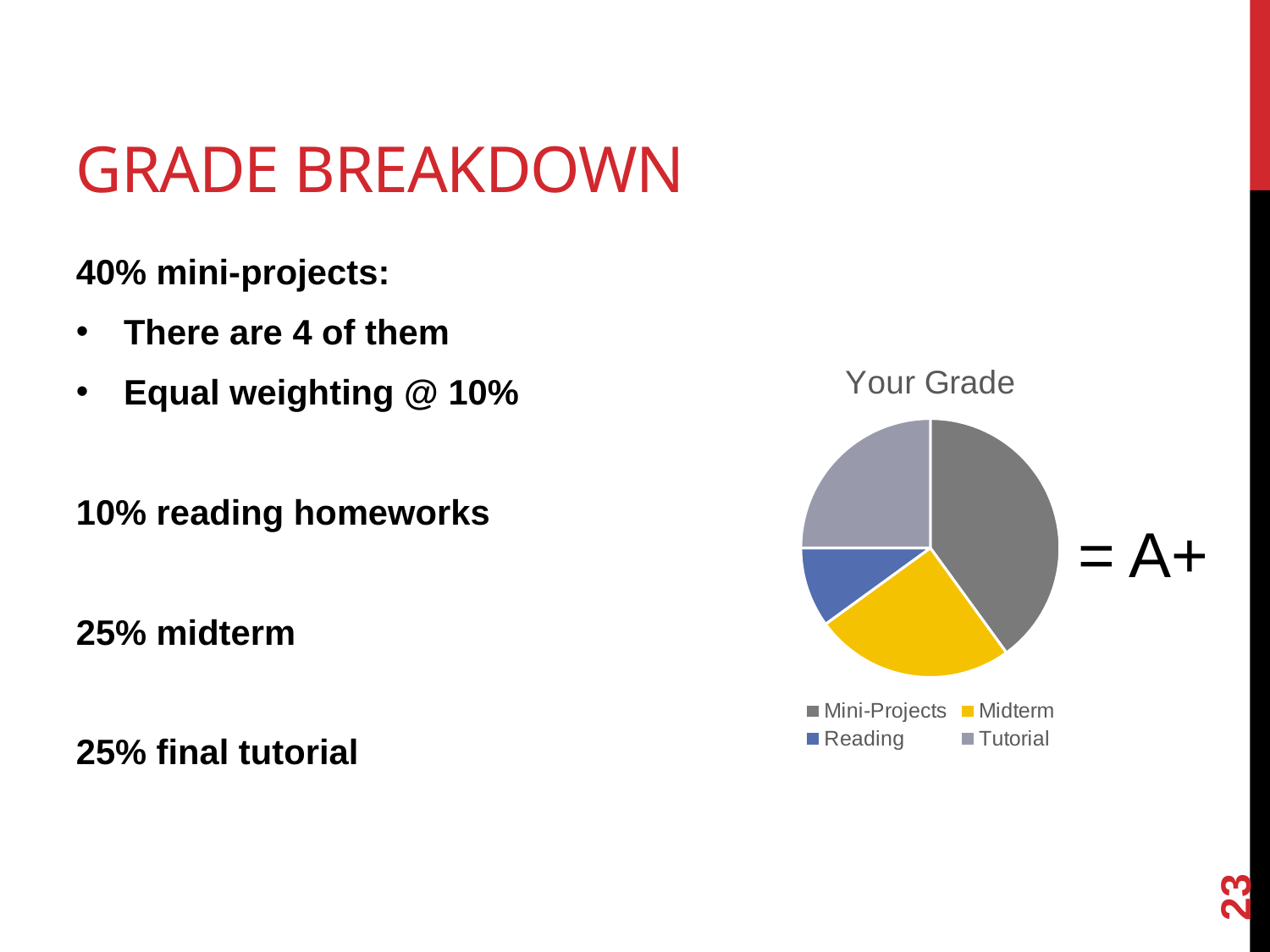
What is the title of the chart? Your Grade Which slice is larger, Midterm or Reading? Midterm Which slice is larger, Reading or Tutorial? Tutorial Which slice is larger, Mini-Projects or Midterm? Mini-Projects Which category has the smallest slice of the pie? Reading What colour is the Midterm slice in the pie chart? yellow How many entries does the chart's legend list? 4 How many slices does the pie chart have? 4 Which category has the largest slice of the pie? Mini-Projects What kind of chart is shown on the slide? pie chart